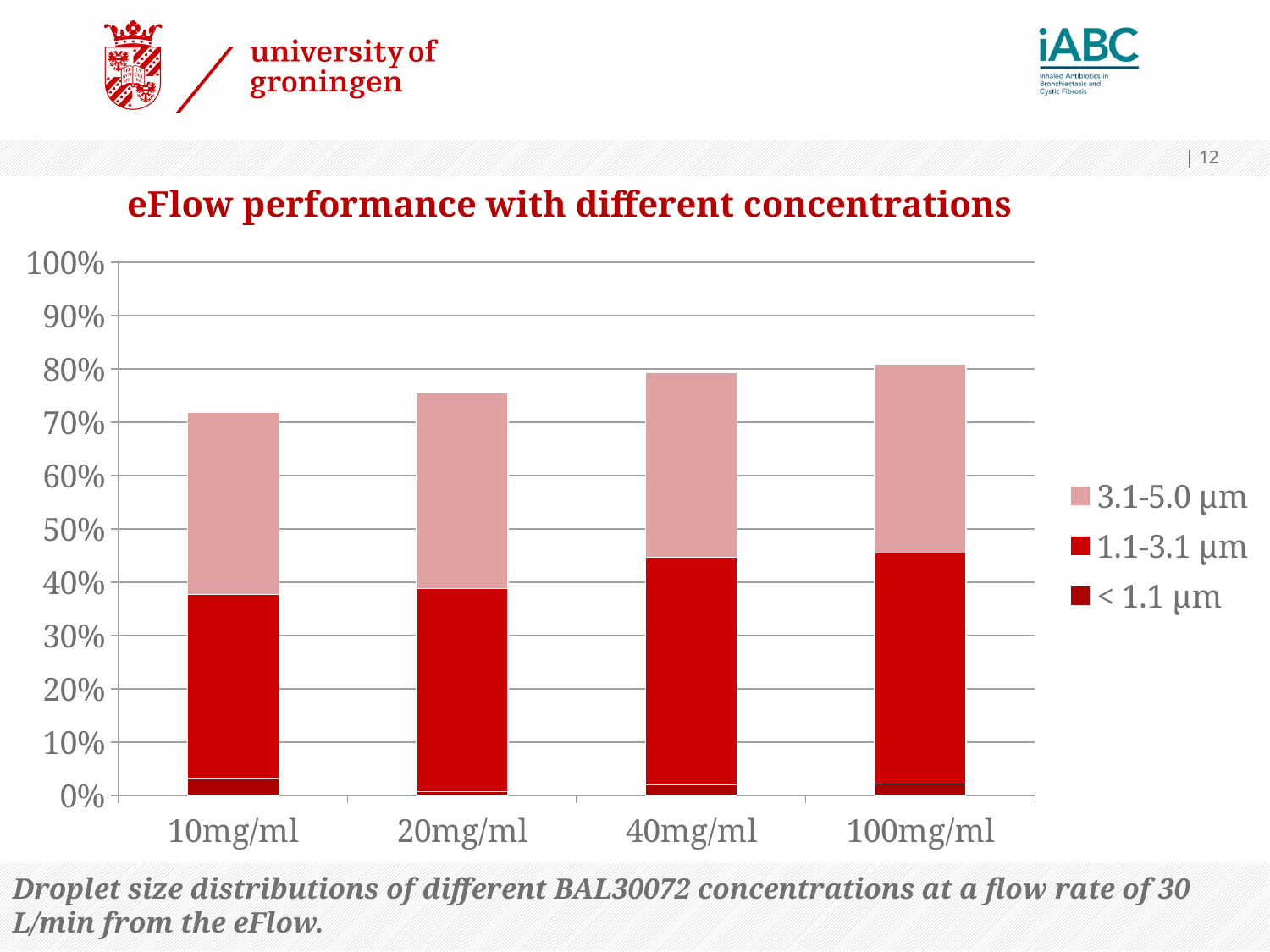
Is the total bar height for 40mg/ml greater or less than 70%? greater What kind of chart is shown on the slide? Stacked bar chart How many concentration categories are shown on the x axis? 4 Is the total bar height for 10mg/ml greater or less than 70%? greater Which legend entry is shown in the lightest pink colour? 3.1-5.0 µm How many series does the legend list? 3 Which has the larger total bar height, 10mg/ml or 100mg/ml? 100mg/ml Which concentration has the lowest total bar height? 10mg/ml Is the total bar height for 10mg/ml greater or less than 80%? less What is the title of the chart? eFlow performance with different concentrations Do the total bar heights rise or fall as concentration increases along the x axis? rise